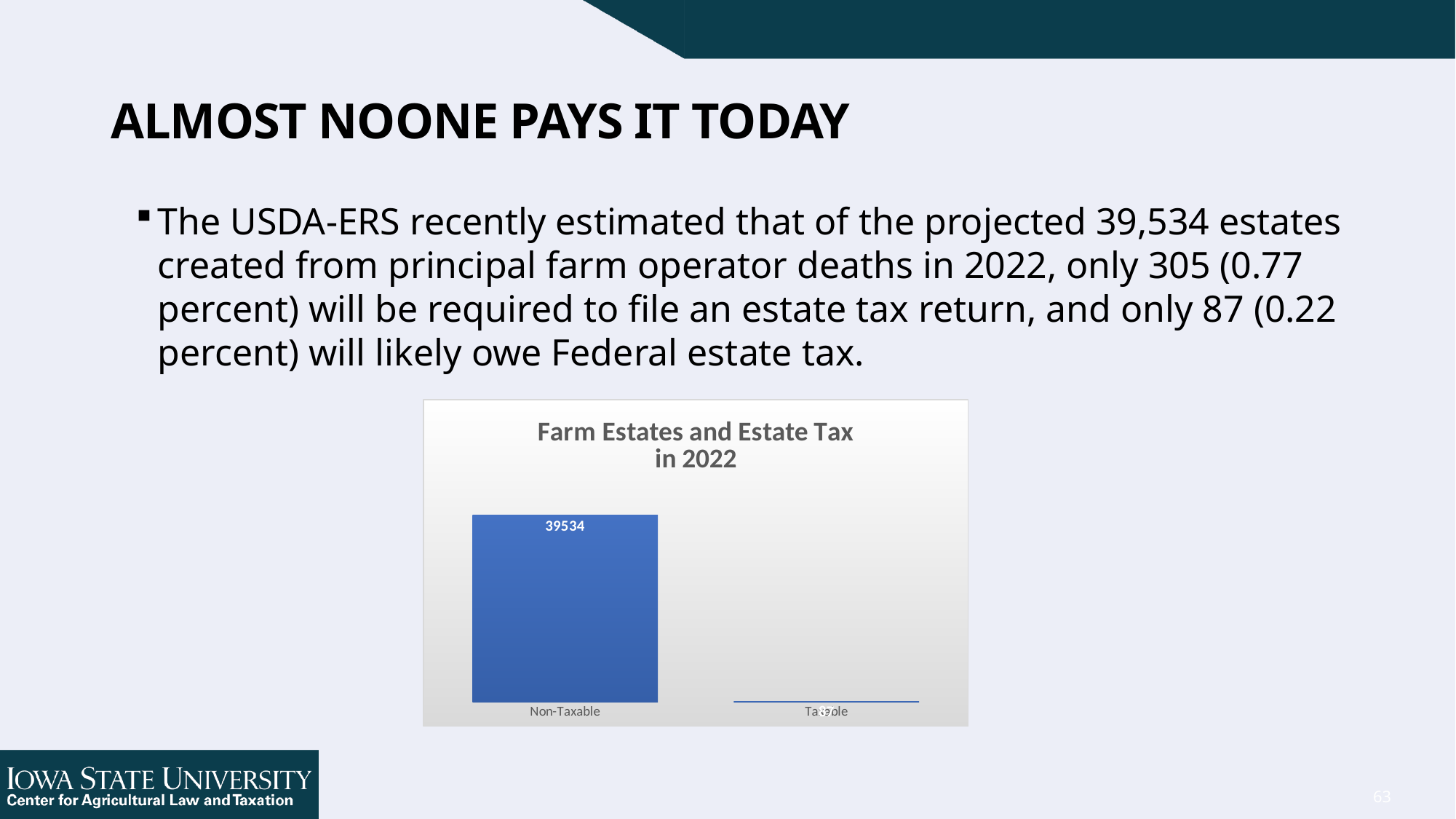
Which category has the highest value in the chart? Non-Taxable What type of chart is shown on the slide? bar chart What colour are the bars in the chart? blue What are the two category labels on the x axis of the chart? Non-Taxable and Taxable Which is larger in the chart, Non-Taxable or Taxable? Non-Taxable What is the title of the chart? Farm Estates and Estate Tax in 2022 What is the value for Non-Taxable in the chart? 39534 How many categories are shown in the chart? 2 Which category has the lowest value in the chart? Taxable